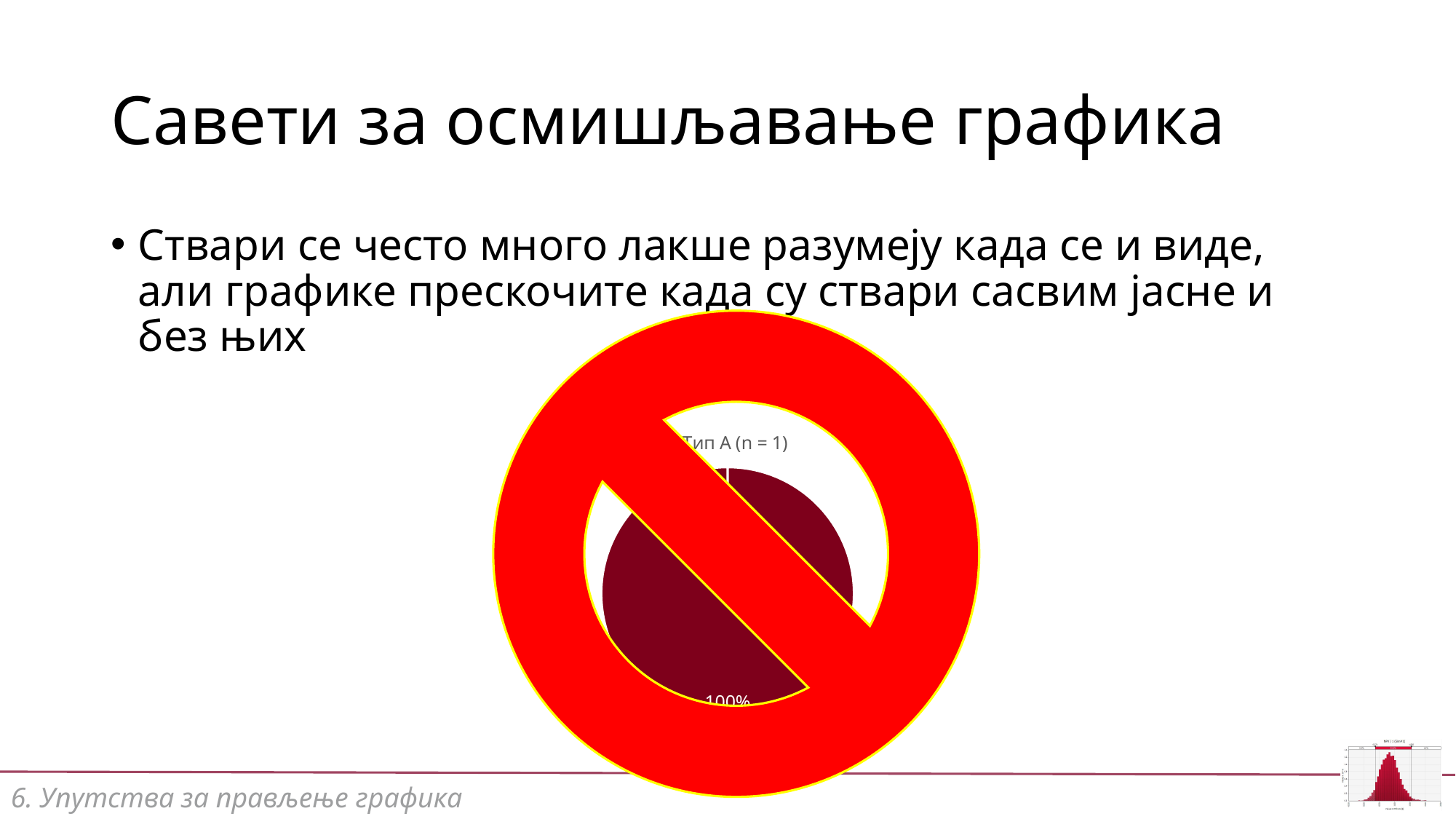
What is the sample size (n) stated in the pie chart's title? 1 How many slices does the pie chart have? 1 What share of the pie chart does the single slice take up? 100% What kind of chart is shown in the centre of the slide? pie chart What value is printed as the data label on the pie chart's slice? 100%